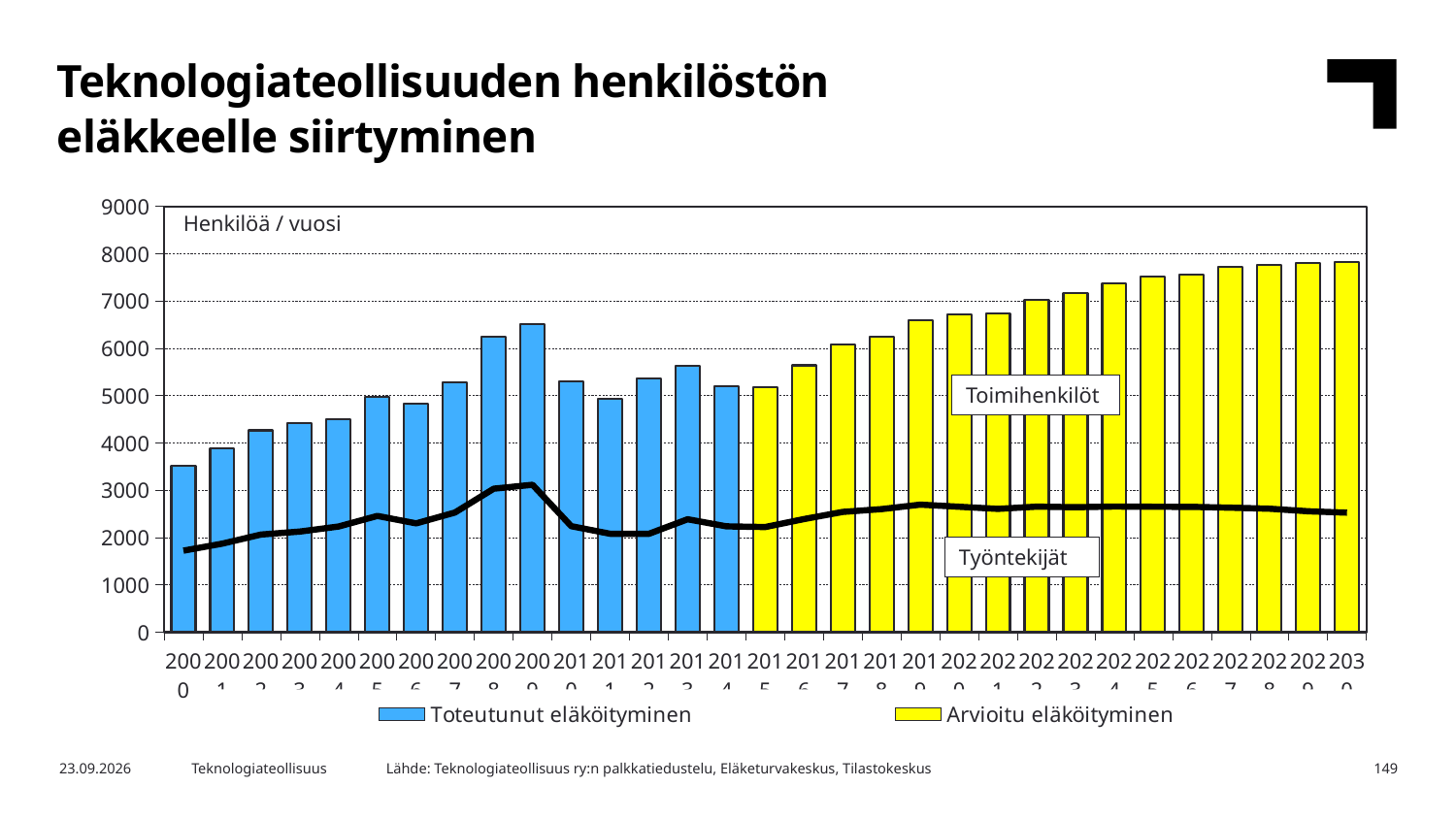
Which year has the lowest bar? 2000 What kind of chart is shown on the slide? combination bar and line chart Is the bar for 2009 greater or less than 6000? greater Is the bar for 2020 greater or less than 6000? greater Is the bar for 2000 greater or less than 4000? less Do the bars rise or fall from 2015 to 2030? rise How many series does the legend list? 2 Which bar is taller, 2009 or 2010? 2009 What unit label is shown in the top-left corner of the plot area? Henkilöä / vuosi How many years (bars) are shown on the x axis? 31 What colour are the bars for 'Arvioitu eläköityminen'? yellow